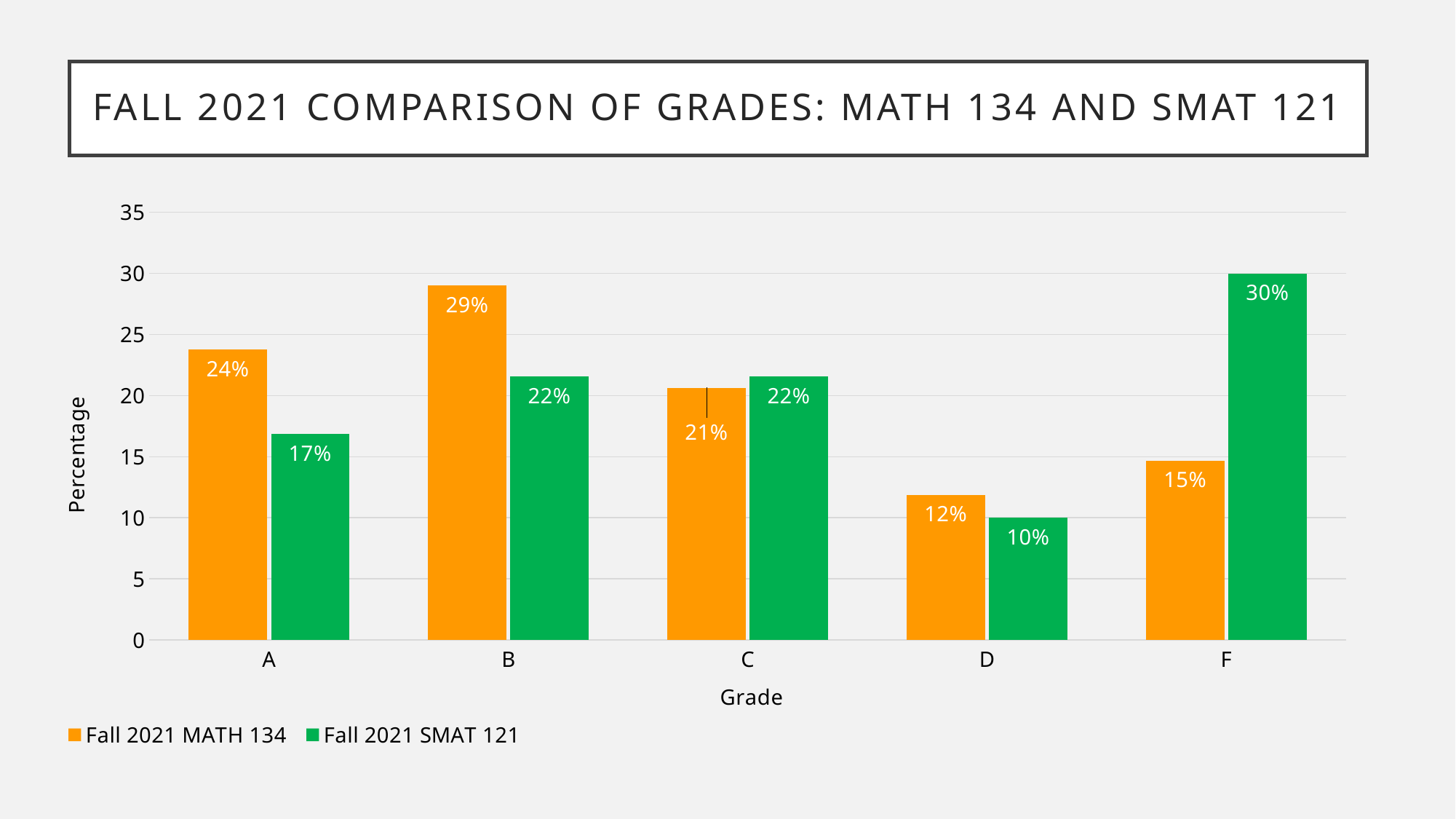
What is the value for grade D in the Fall 2021 SMAT 121 series? 10% How many grade categories are shown on the x axis? 5 What is the difference between the Fall 2021 MATH 134 and Fall 2021 SMAT 121 percentages for grade A? 7% What is the label of the y axis? Percentage What percentage of Fall 2021 MATH 134 students received a grade of B? 29% Which grade has the highest percentage for Fall 2021 MATH 134? B Is the Fall 2021 MATH 134 value for grade B greater or less than 25? greater What kind of chart is shown on the slide? Bar chart Which grade has the lowest percentage for Fall 2021 SMAT 121? D How many series does the legend list? 2 For grade F, which series has the larger percentage, Fall 2021 MATH 134 or Fall 2021 SMAT 121? Fall 2021 SMAT 121 What percentage of Fall 2021 SMAT 121 students received a grade of F? 30%